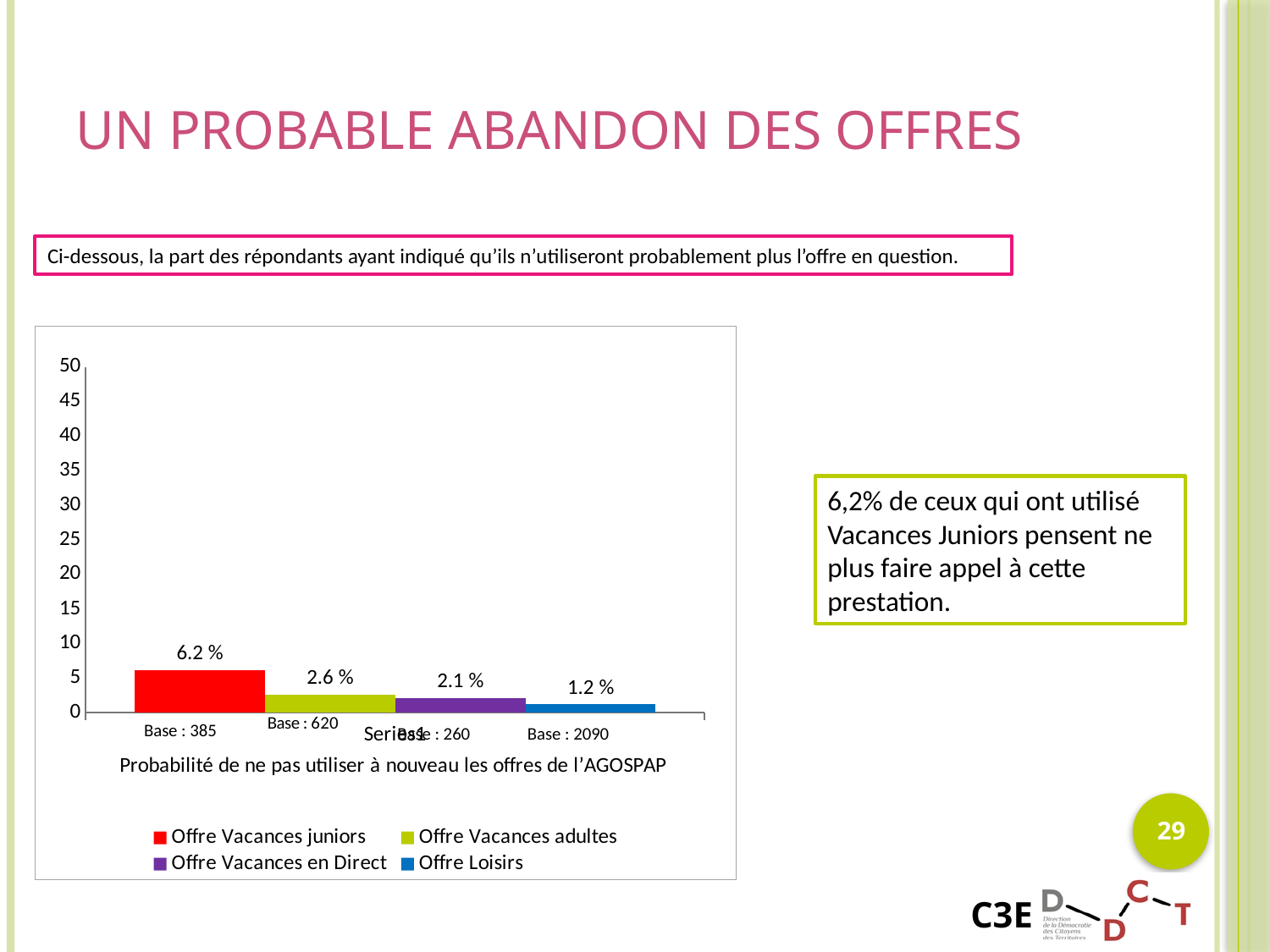
How many series does the legend list? 4 Which offer has the highest share of respondents who will probably no longer use it? Offre Vacances juniors What kind of chart is shown on the slide? Bar chart What value is shown for Offre Vacances en Direct? 2.1 % What is the difference between the values for Offre Vacances juniors and Offre Loisirs? 5.0 % What value is shown for Offre Loisirs? 1.2 % What value is shown for Offre Vacances juniors? 6.2 % Which is larger, the value for Offre Vacances adultes or the value for Offre Vacances en Direct? Offre Vacances adultes Which offer has the lowest value in the chart? Offre Loisirs What is the base (number of respondents) shown under the Offre Loisirs bar? Base : 2090 Is the value for Offre Vacances juniors greater or less than 10? less What value is shown for Offre Vacances adultes? 2.6 %